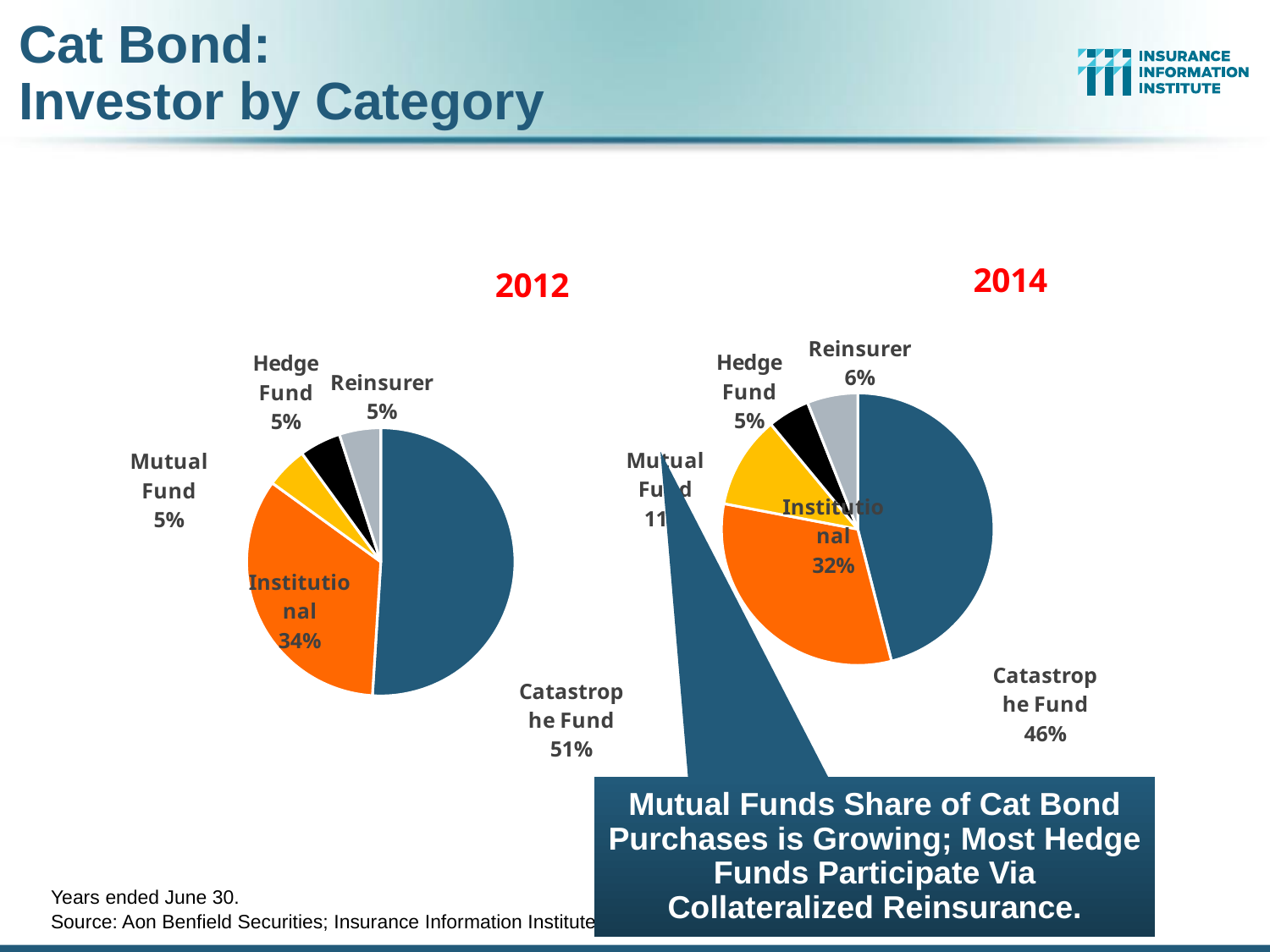
In the 2014 pie chart, which category has the largest share? Catastrophe Fund Is the Institutional share larger in the 2012 pie chart or the 2014 pie chart? 2012 In the 2012 pie chart, what is the difference between the Catastrophe Fund share and the Institutional share? 17 percentage points In the 2014 pie chart, what share is shown for the Catastrophe Fund category? 46% How many investor categories are shown in the 2012 pie chart? 5 In the 2012 pie chart, which category has the largest share? Catastrophe Fund By how many percentage points did the Catastrophe Fund share fall from the 2012 pie chart to the 2014 pie chart? 5 percentage points In the 2012 pie chart, what share of cat bond investors is the Catastrophe Fund category? 51% In the 2014 pie chart, what share is shown for Reinsurer? 6% What type of chart is used to show investor by category on this slide? Pie chart In the 2014 pie chart, what share is shown for Institutional investors? 32% In the 2012 pie chart, what share is shown for Institutional investors? 34%